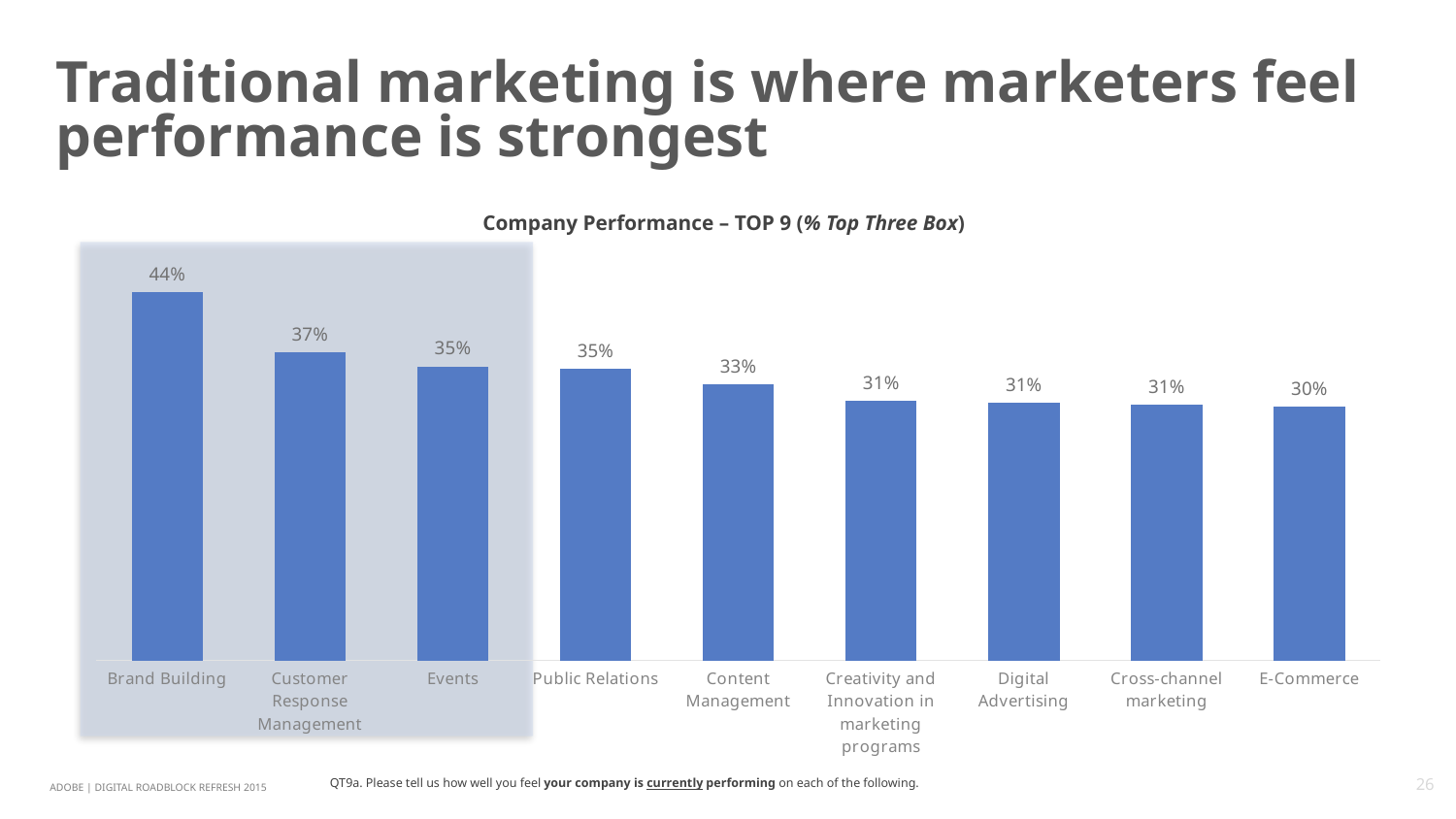
What is the value for Content Management? 33% What is the difference between the values for Customer Response Management and Public Relations? 2% What kind of chart is shown on the slide? Bar chart How many categories are shown in the chart? 9 What is the title of the chart? Company Performance – TOP 9 (% Top Three Box) What is the value for E-Commerce? 30% Which category has the highest value? Brand Building Which category has the lowest value? E-Commerce What is the value for Customer Response Management? 37% What is the difference between the values for Brand Building and E-Commerce? 14% Which is larger, the value for Events or the value for Digital Advertising? Events What is the value for Brand Building? 44%